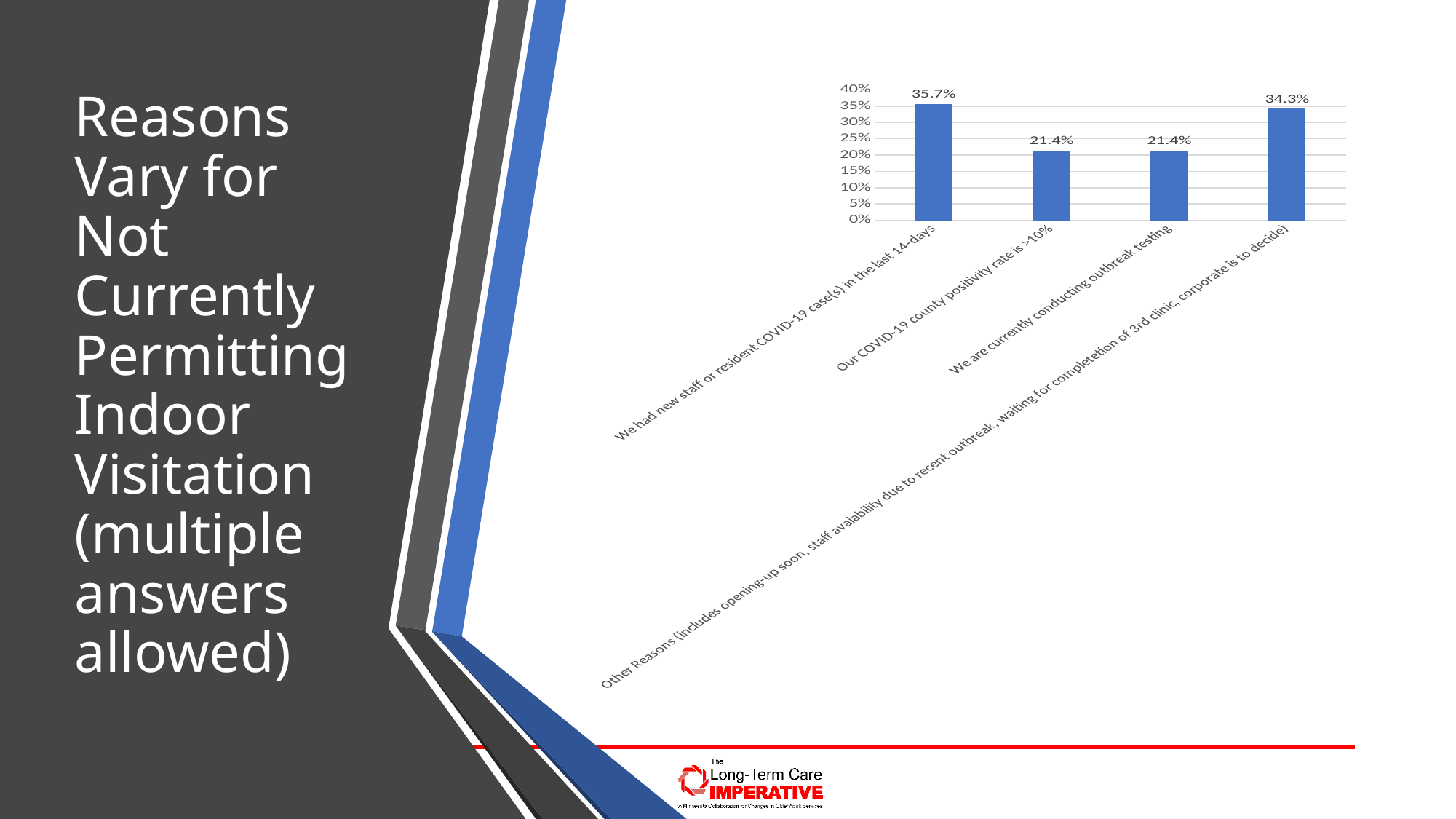
Which reason has the highest percentage? We had new staff or resident COVID-19 case(s) in the last 14-days How many reason categories are shown in the chart? 4 What percentage is shown for the "Other Reasons" category? 34.3% What is the difference between the value for "We had new staff or resident COVID-19 case(s) in the last 14-days" and the value for "Other Reasons"? 1.4 percentage points Is the value for "Other Reasons" greater or less than 30%? greater What percentage of respondents cited "We had new staff or resident COVID-19 case(s) in the last 14-days" as a reason? 35.7% What is the difference between the value for "We had new staff or resident COVID-19 case(s) in the last 14-days" and the value for "Our COVID-19 county positivity rate is >10%"? 14.3 percentage points What is the maximum value shown on the vertical axis of the chart? 40% What is the value for "We are currently conducting outbreak testing"? 21.4% What kind of chart is shown on the slide? Bar chart Which is larger: the value for "We had new staff or resident COVID-19 case(s) in the last 14-days" or the value for "Other Reasons"? We had new staff or resident COVID-19 case(s) in the last 14-days What is the value for "Our COVID-19 county positivity rate is >10%"? 21.4%